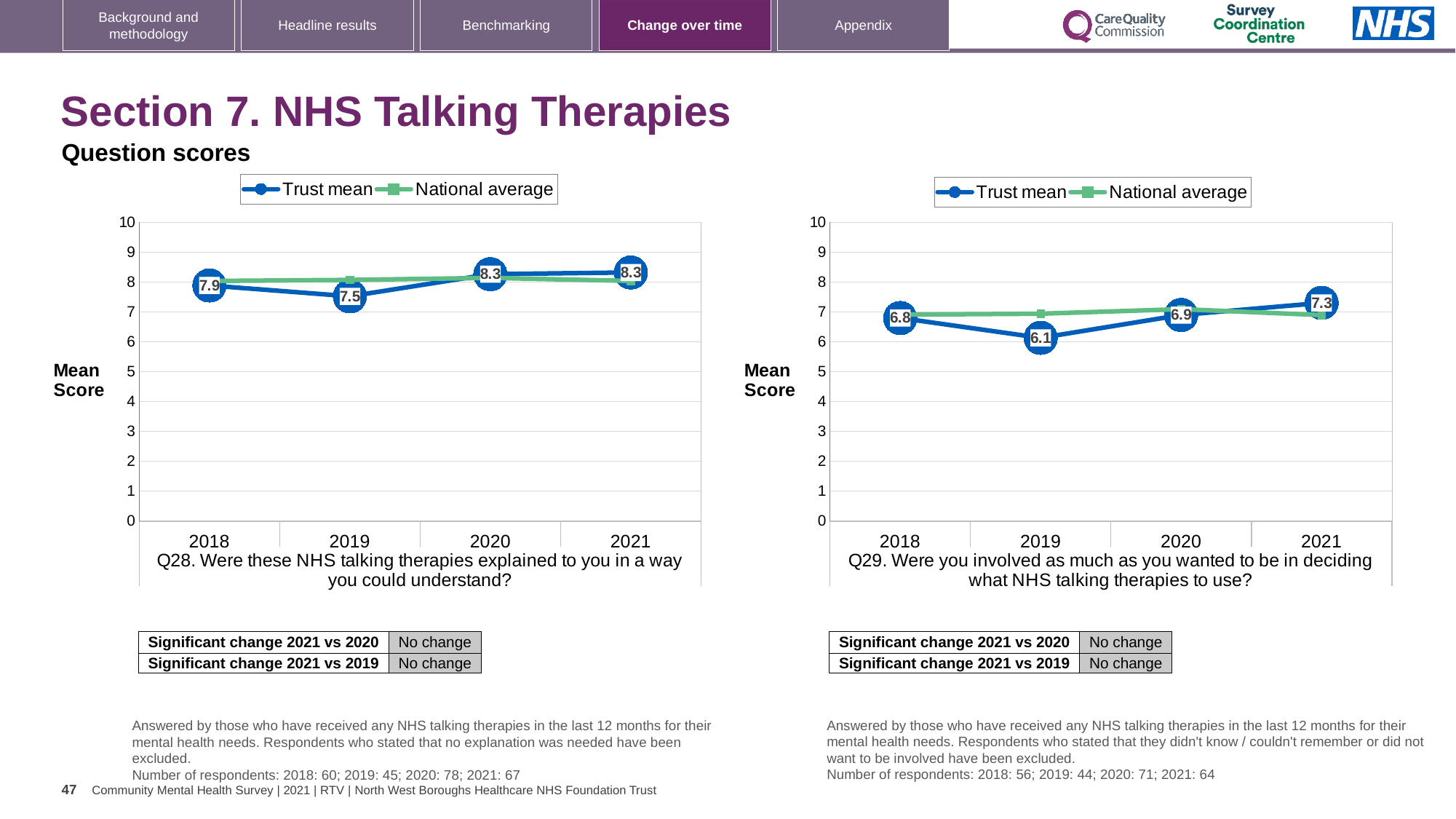
In the Q29 chart (right), what is the difference between the Trust mean scores for 2021 and 2019? 1.2 How many years are shown on the x axis of the Q28 chart (left)? 4 In the Q28 chart (left), what is the Trust mean score for 2018? 7.9 In the Q29 chart (right), which year has the highest Trust mean score? 2021 In the Q29 chart (right), which year has the lowest Trust mean score? 2019 In the Q28 chart (left), is the National average for 2019 greater or less than 6? greater What type of chart is used for the Q28 chart (left)? Line chart How many series does the legend of the Q29 chart (right) list? 2 In the Q29 chart (right), is the Trust mean score higher in 2018 or 2019? 2018 In the Q29 chart (right), what is the Trust mean score for 2021? 7.3 In the Q28 chart (left), what is the Trust mean score for 2019? 7.5 In the Q28 chart (left), what is the difference between the Trust mean scores for 2020 and 2019? 0.8